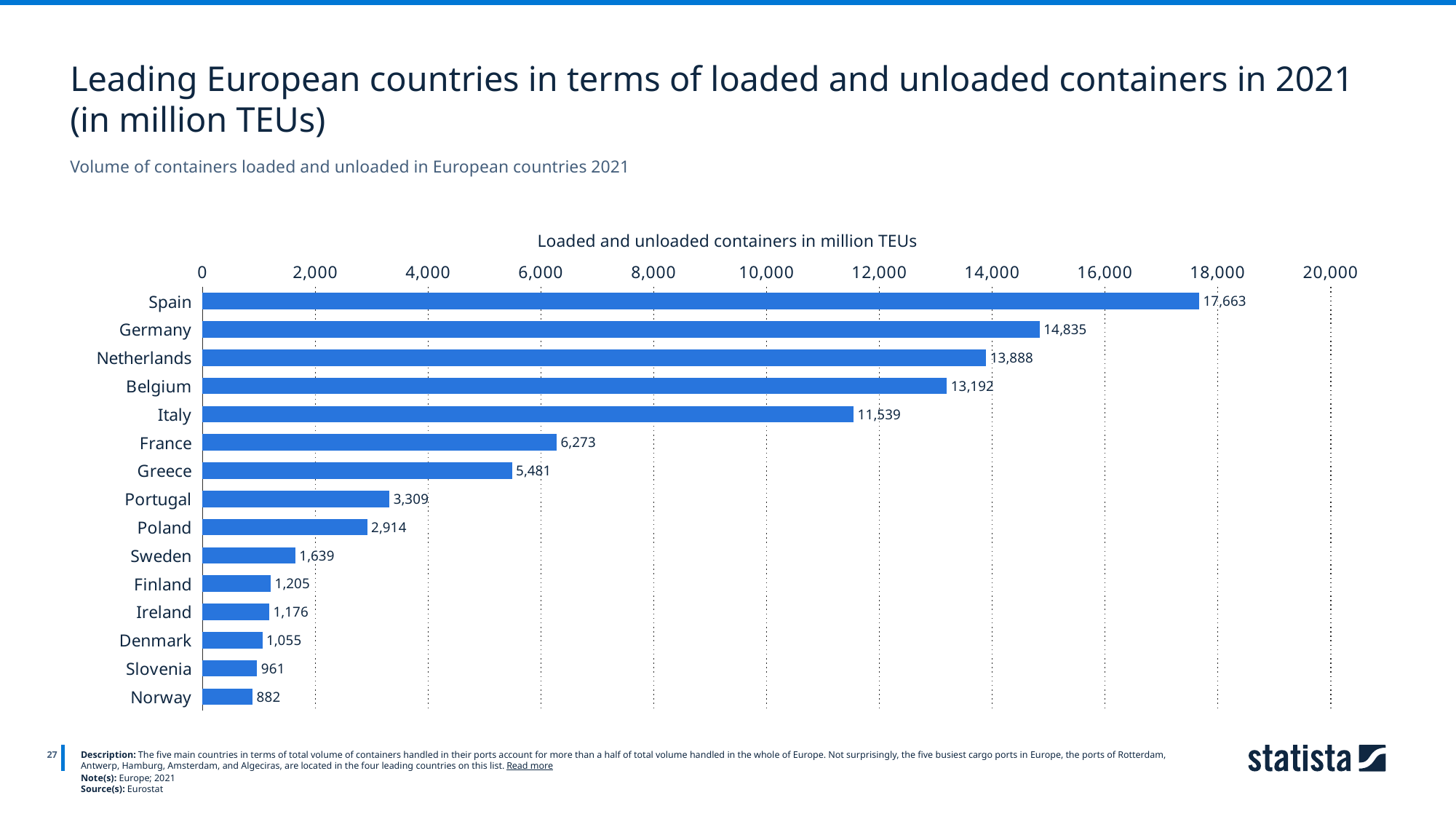
Is the value for Italy greater or less than 12,000? less What is the value for Denmark? 1,055 What is the value for Spain? 17,663 How many countries are shown in the chart? 15 Which country has the lowest value? Norway What kind of chart is shown on the slide? bar chart Which country has the highest value? Spain What is the value for Greece? 5,481 Which is larger, the value for Portugal or the value for Poland? Portugal What is the difference between the values for Germany and the Netherlands? 947 What is the title of the chart's axis label above the bars? Loaded and unloaded containers in million TEUs What is the difference between the values for France and Greece? 792